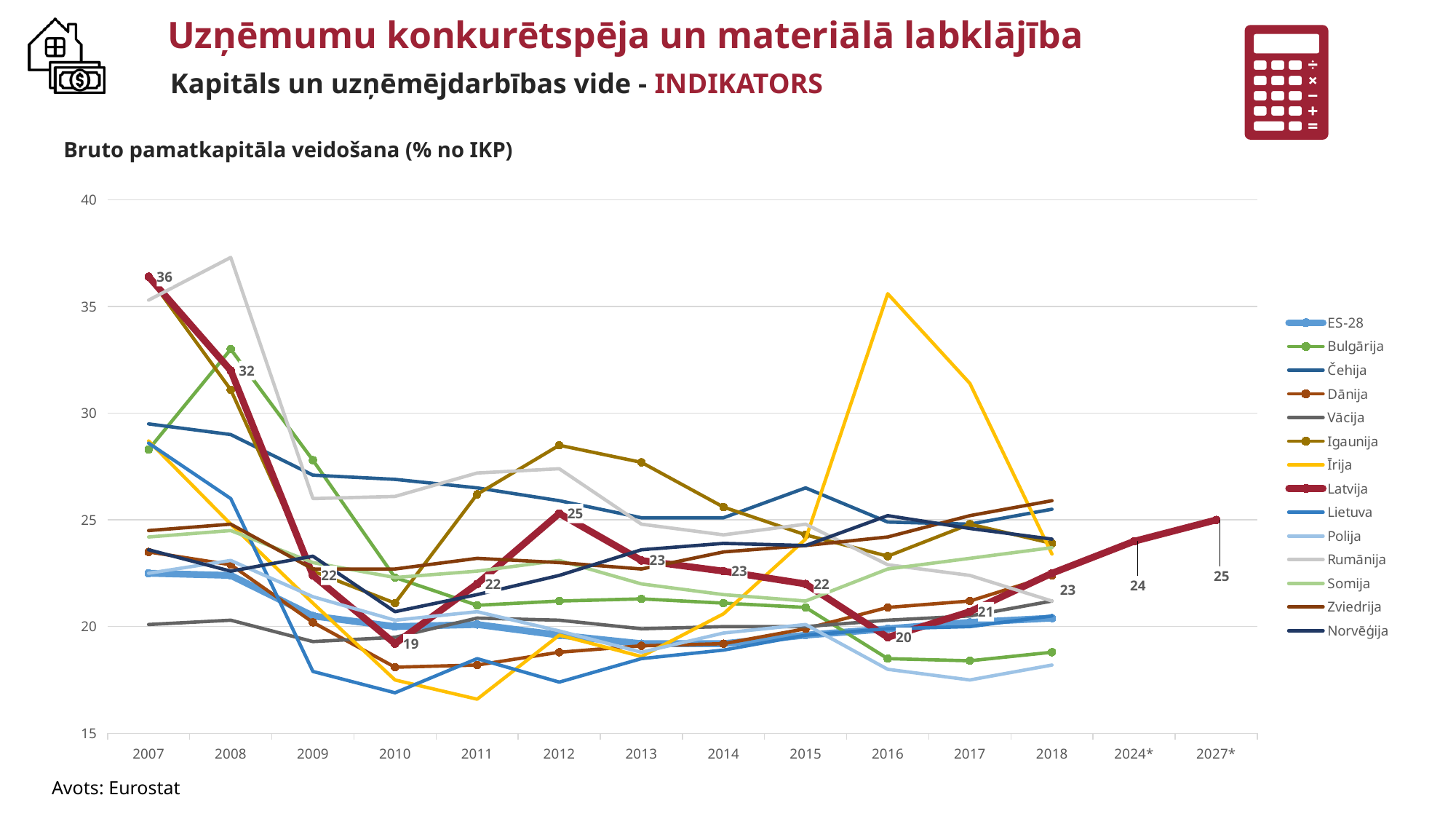
Which year has the larger Latvija value, 2012 or 2016? 2012 What is the difference between the Latvija values for 2007 and 2010? 17 How many series does the legend list? 14 In which year is the Latvija series at its lowest? 2010 What is the projected value for Latvija in 2027*? 25 What kind of chart is shown on the slide? line chart How many years are shown on the x axis? 14 In which year is the Latvija series at its highest? 2007 What is the value for Latvija in 2007? 36 Is the value for Īrija in 2016 greater or less than 30? greater Is the value for Lietuva in 2010 greater or less than 20? less What is the value for Latvija in 2010? 19